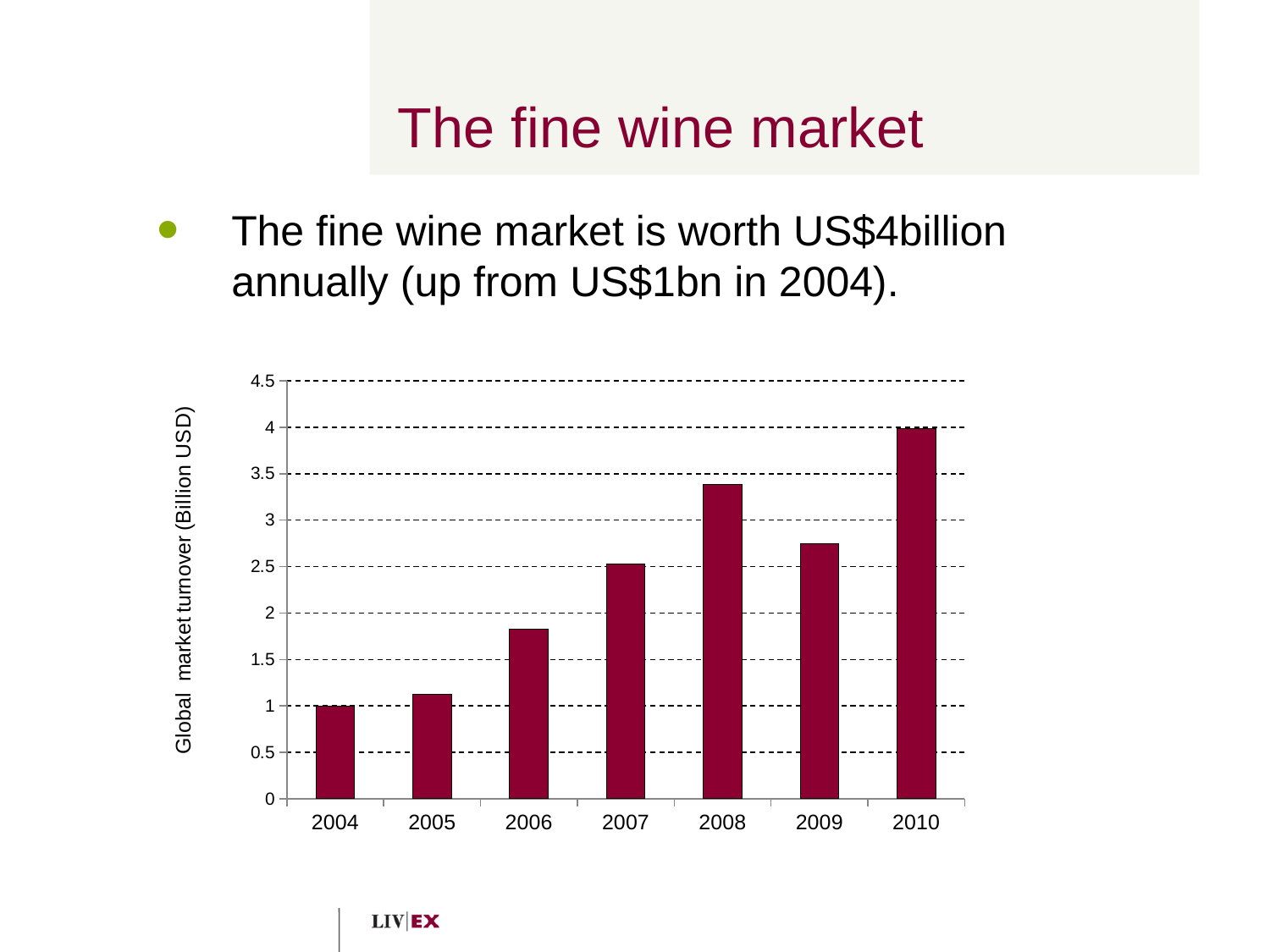
What is the global market turnover for 2004 in the chart? 1 Which year has the lowest global market turnover in the chart? 2004 Do the values generally rise or fall from 2004 to 2010? Rise Is the value for 2009 greater or less than 2.5? greater What is the label on the y axis of the chart? Global market turnover (Billion USD) How many years are shown on the x axis of the chart? 7 What kind of chart is shown on the slide? Bar chart Which year has the larger value, 2008 or 2009? 2008 Is the value for 2008 greater or less than 3? greater Which year has the highest global market turnover in the chart? 2010 Is the value for 2006 greater or less than 2? less